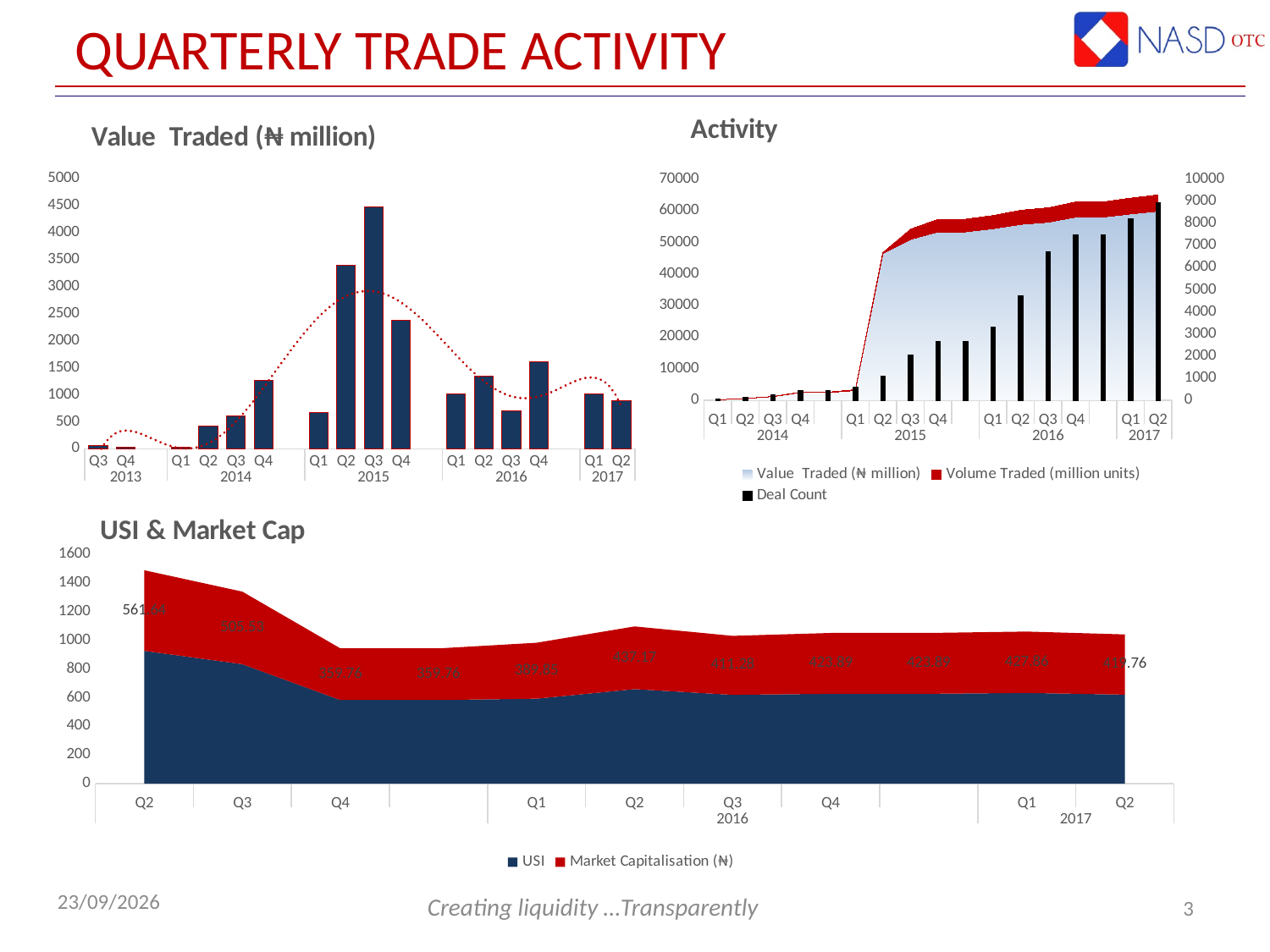
In the "Value Traded (₦ million)" chart, is the value for Q2 2014 greater or less than 500? less In the "Activity" chart, does the Deal Count generally rise or fall from Q1 2014 to Q2 2017? Rise In the "Activity" chart, is the Deal Count for Q2 2017 greater or less than 8000 on the right-hand axis? greater In the "Value Traded (₦ million)" chart, which quarter has the highest value traded? Q3 2015 In the "Value Traded (₦ million)" chart, is the value for Q2 2015 greater or less than 3000? greater What are the two legend entries of the "USI & Market Cap" chart? USI and Market Capitalisation (₦) How many series does the legend of the "USI & Market Cap" chart list? 2 How many series does the legend of the "Activity" chart list? 3 What kind of chart is the "Value Traded (₦ million)" chart? Bar chart How many quarterly bars are plotted in the "Value Traded (₦ million)" chart? 16 In the "Value Traded (₦ million)" chart, which is larger: the value for Q2 2015 or Q4 2015? Q2 2015